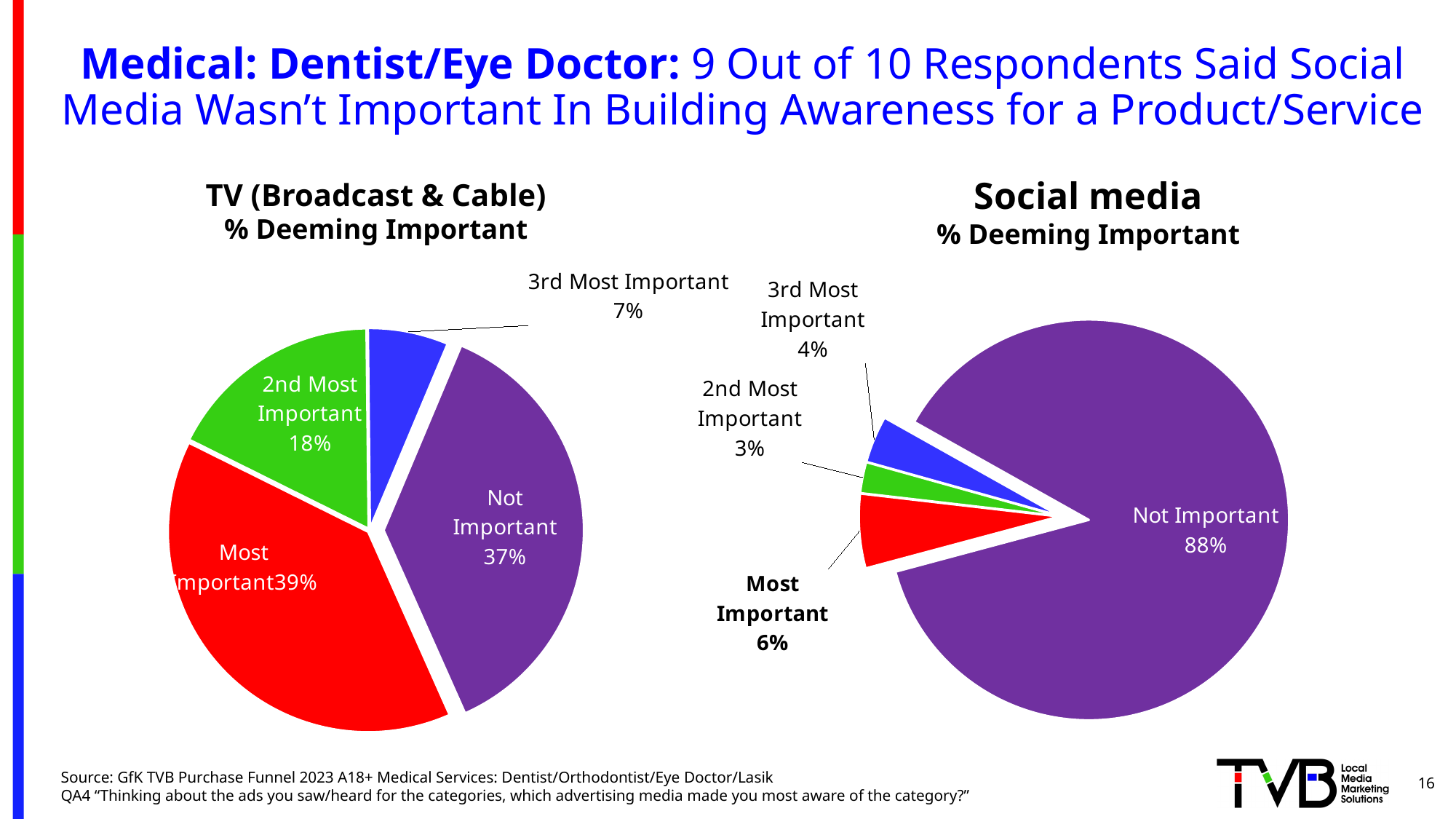
In the Social media pie chart, what is the value for 3rd Most Important? 4% In the Social media pie chart, what percentage deemed social media Not Important? 88% In the TV (Broadcast & Cable) pie chart, what is the value for 2nd Most Important? 18% In the Social media pie chart, which category has the smallest share? 2nd Most Important Which is larger in the TV (Broadcast & Cable) pie chart: 2nd Most Important or 3rd Most Important? 2nd Most Important In the Social media pie chart, what is the difference between Not Important and Most Important? 82% How many slices does the Social media pie chart have? 4 In the TV (Broadcast & Cable) pie chart, what percentage deemed TV Most Important? 39% In the TV (Broadcast & Cable) pie chart, which category has the largest share? Most Important In the TV (Broadcast & Cable) pie chart, what is the difference between Most Important and Not Important? 2% What type of chart is used for TV (Broadcast & Cable)? Pie chart What colour is the Not Important slice in the Social media pie chart? Purple